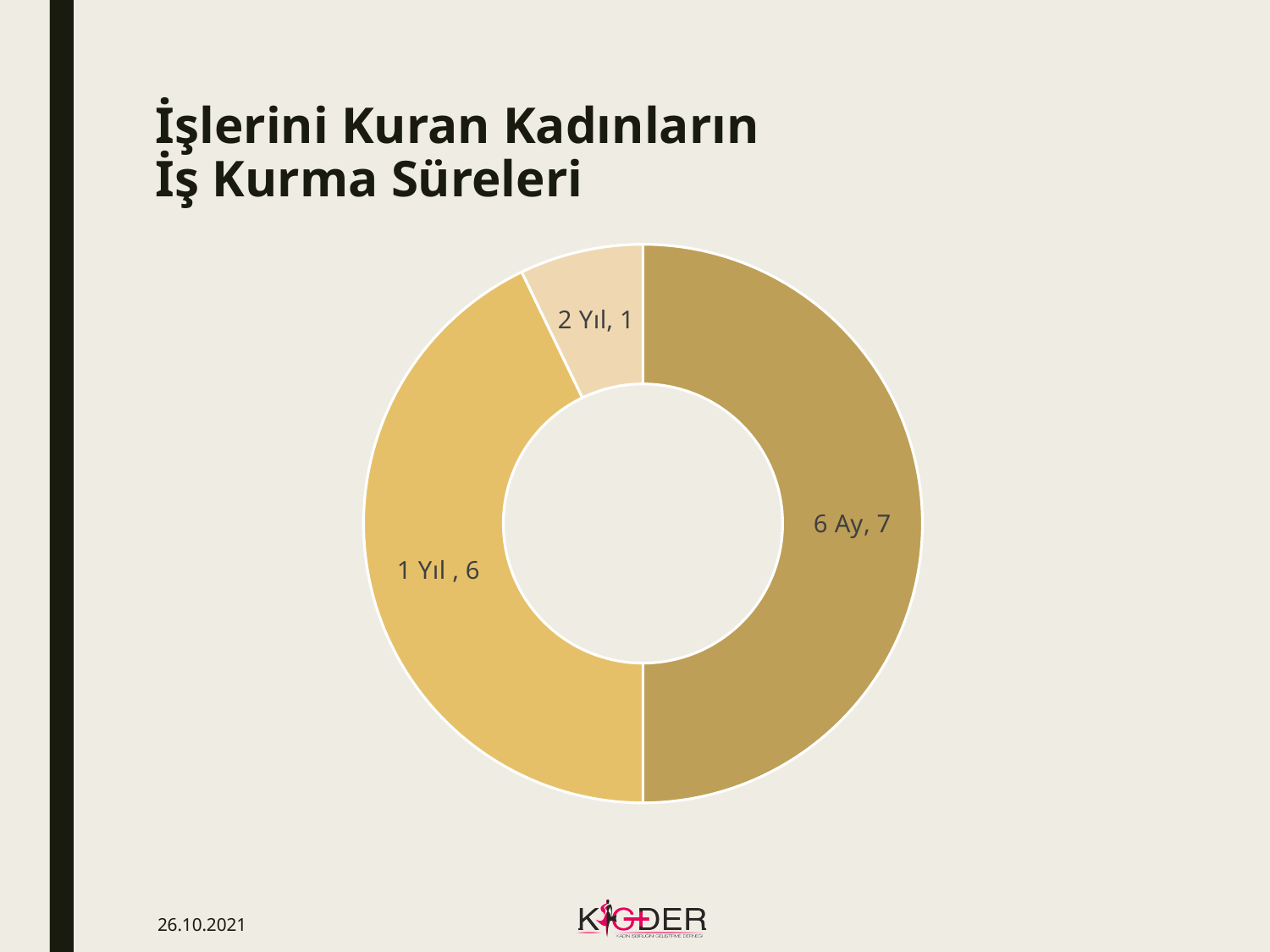
Which is larger, the value for "6 Ay" or the value for "1 Yıl"? 6 Ay What value is shown for the "2 Yıl" slice? 1 Which category has the smallest slice? 2 Yıl How many categories are shown in the chart? 3 What is the difference between the values for "6 Ay" and "2 Yıl"? 6 Which category has the largest slice? 6 Ay What value is shown for the "6 Ay" slice? 7 What is the total of all the values in the chart? 14 What value is shown for the "1 Yıl" slice? 6 What share of the whole does the "6 Ay" slice represent? 50% What kind of chart is shown on the slide? doughnut chart What is the difference between the values for "1 Yıl" and "2 Yıl"? 5